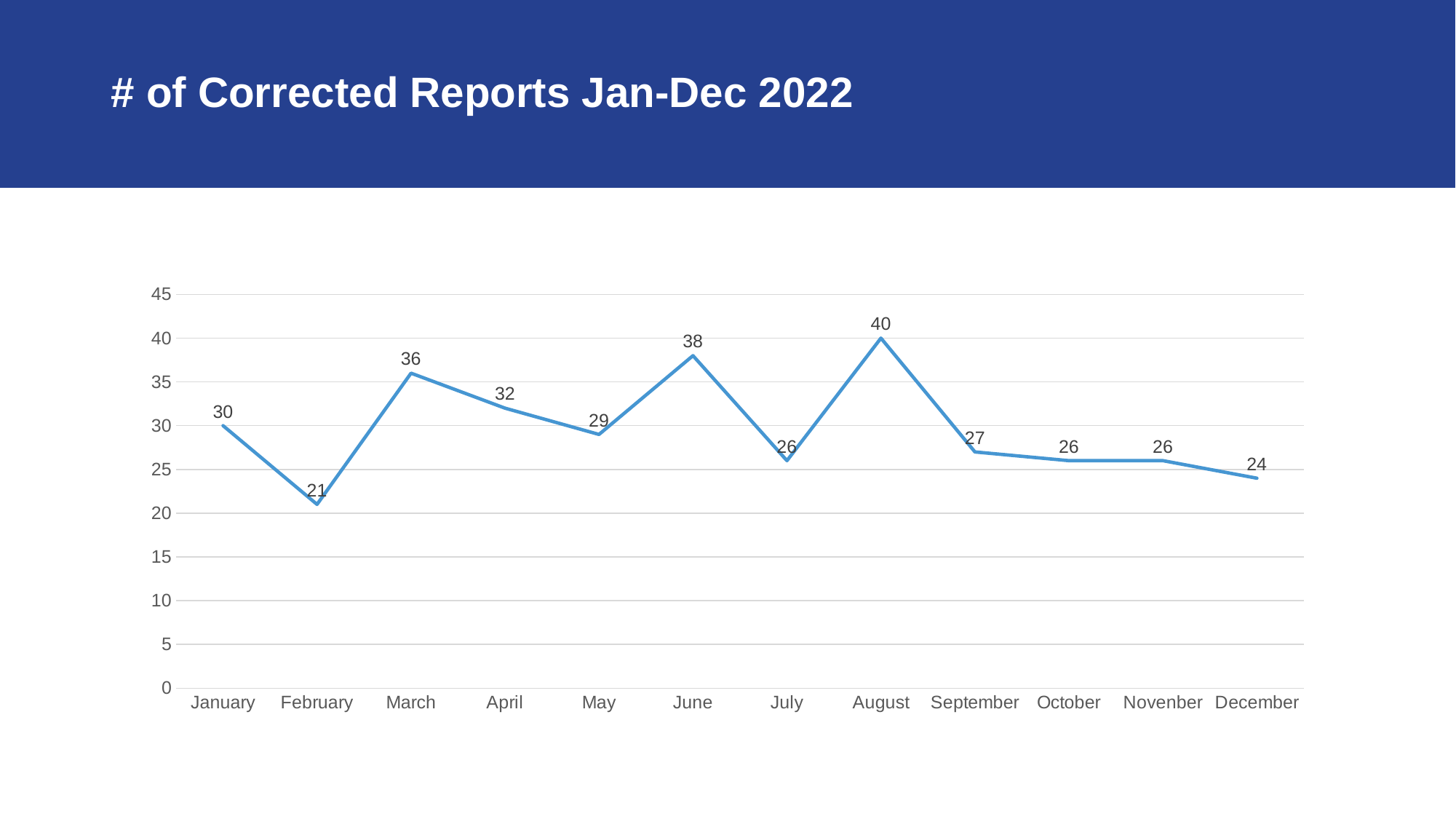
What is the title of the chart? # of Corrected Reports Jan-Dec 2022 What is the number of corrected reports in December? 24 What is the difference between the number of corrected reports in June and in July? 12 What is the number of corrected reports in August? 40 Which month has the highest number of corrected reports? August Which month has more corrected reports, January or April? April Is the value for May greater or less than 25? greater Do the values rise or fall from August to December? Fall How many months are plotted on the chart? 12 Which month has the lowest number of corrected reports? February What is the number of corrected reports in March? 36 What kind of chart is shown on the slide? Line chart